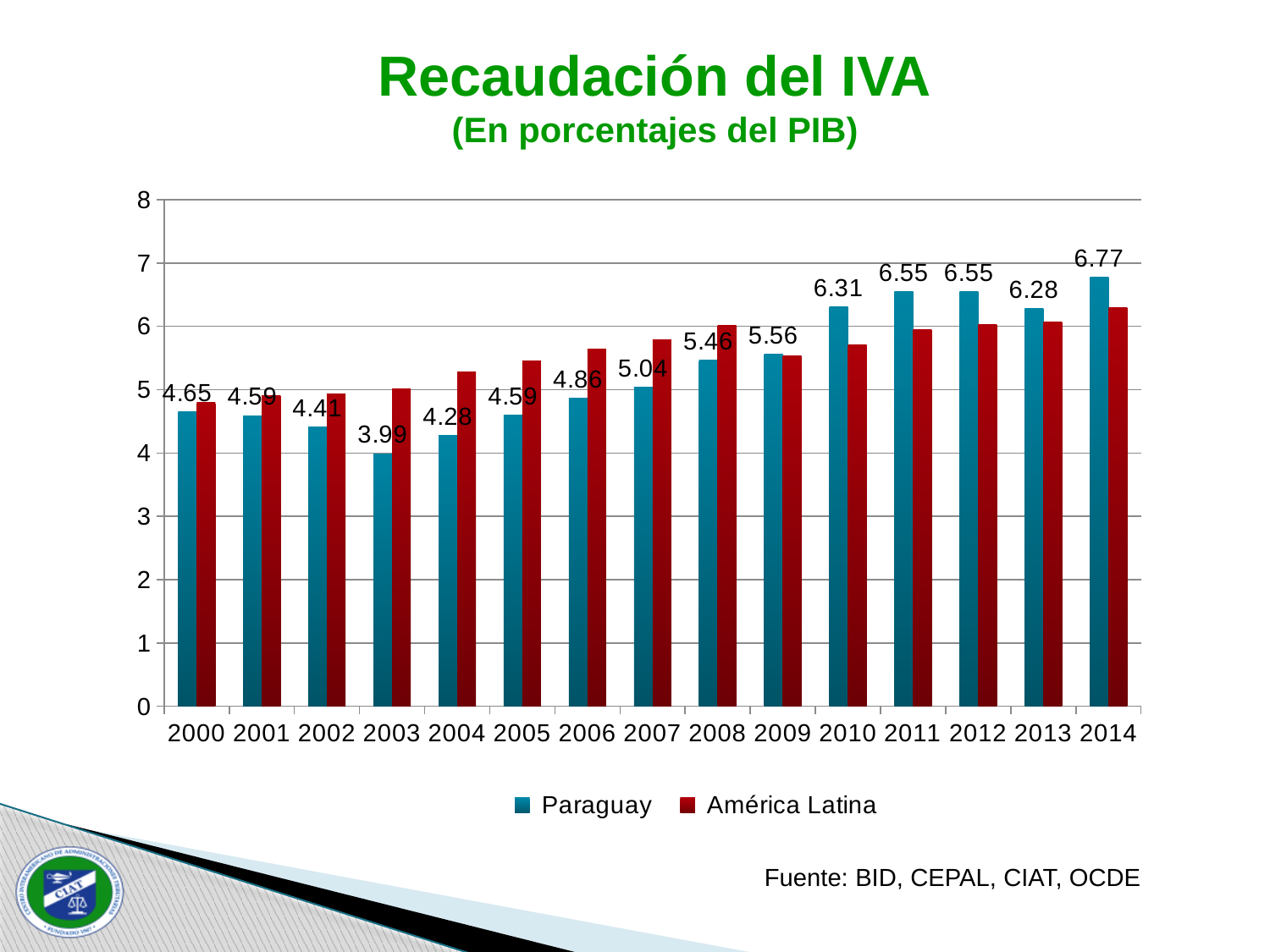
What is the difference between the Paraguay values for 2014 and 2000? 2.12 Which is larger for Paraguay: the value in 2010 or the value in 2013? 2010 What kind of chart is shown on the slide? Bar chart What is the value for Paraguay in 2014? 6.77 How many series does the legend list? 2 How many years are shown on the x axis? 15 In which year is the Paraguay value lowest? 2003 What is the value for Paraguay in 2008? 5.46 In which year is the Paraguay value highest? 2014 What is the value for Paraguay in 2003? 3.99 Is the value for América Latina in 2000 greater or less than 5? less Is the value for América Latina in 2014 greater or less than 6? greater